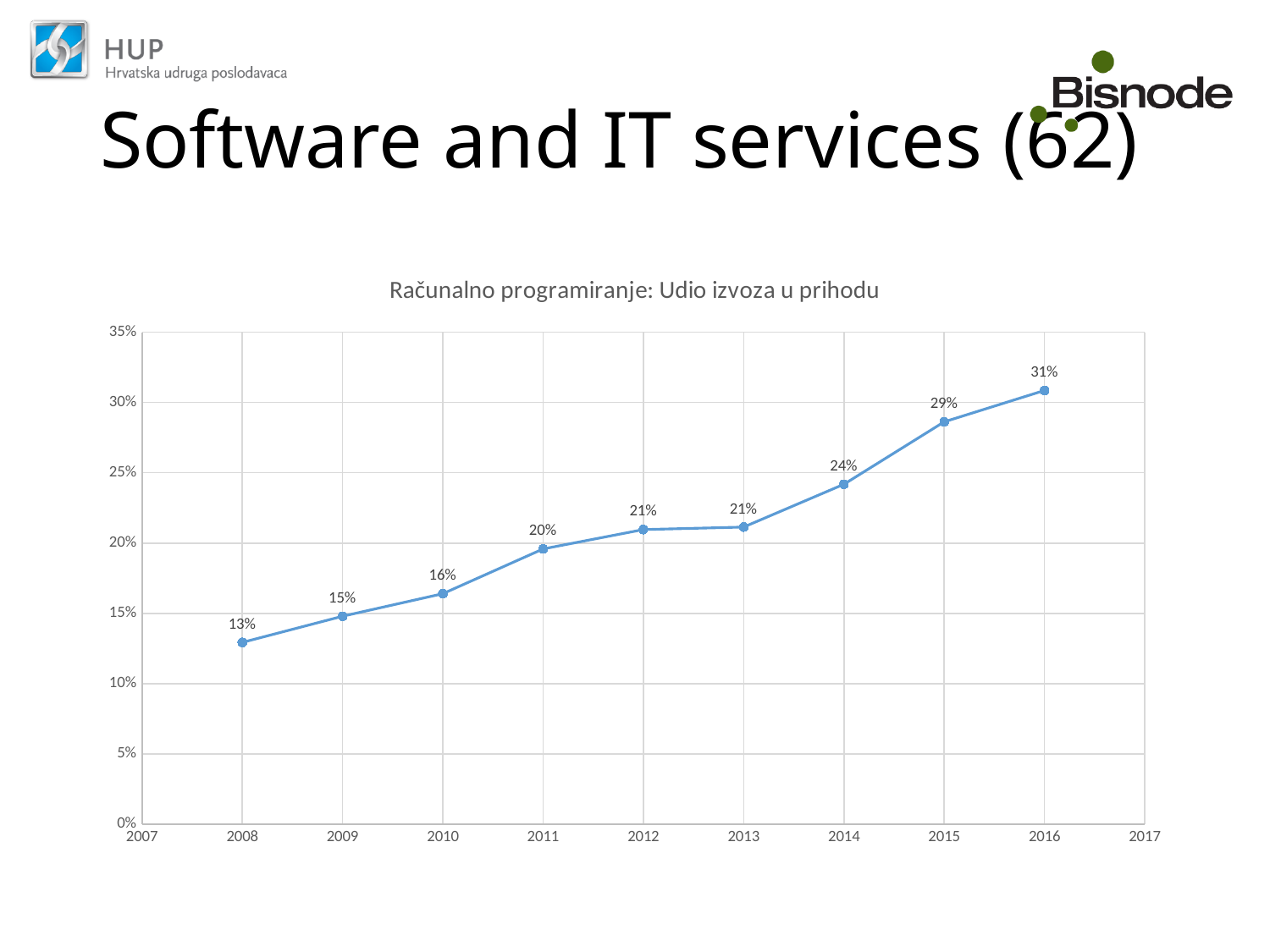
Which year has the highest value? 2016 What is the value for 2014? 24% What is the value for 2016? 31% What is the difference between the values for 2016 and 2008? 18% What kind of chart is shown on the slide? line chart Do the values generally rise or fall from 2008 to 2016? rise What is the value for 2008? 13% Which year has the lowest value? 2008 Which is larger, the value for 2015 or the value for 2010? 2015 What is the value for 2011? 20% How many data points are plotted on the line? 9 Is the value for 2013 greater or less than 25%? less